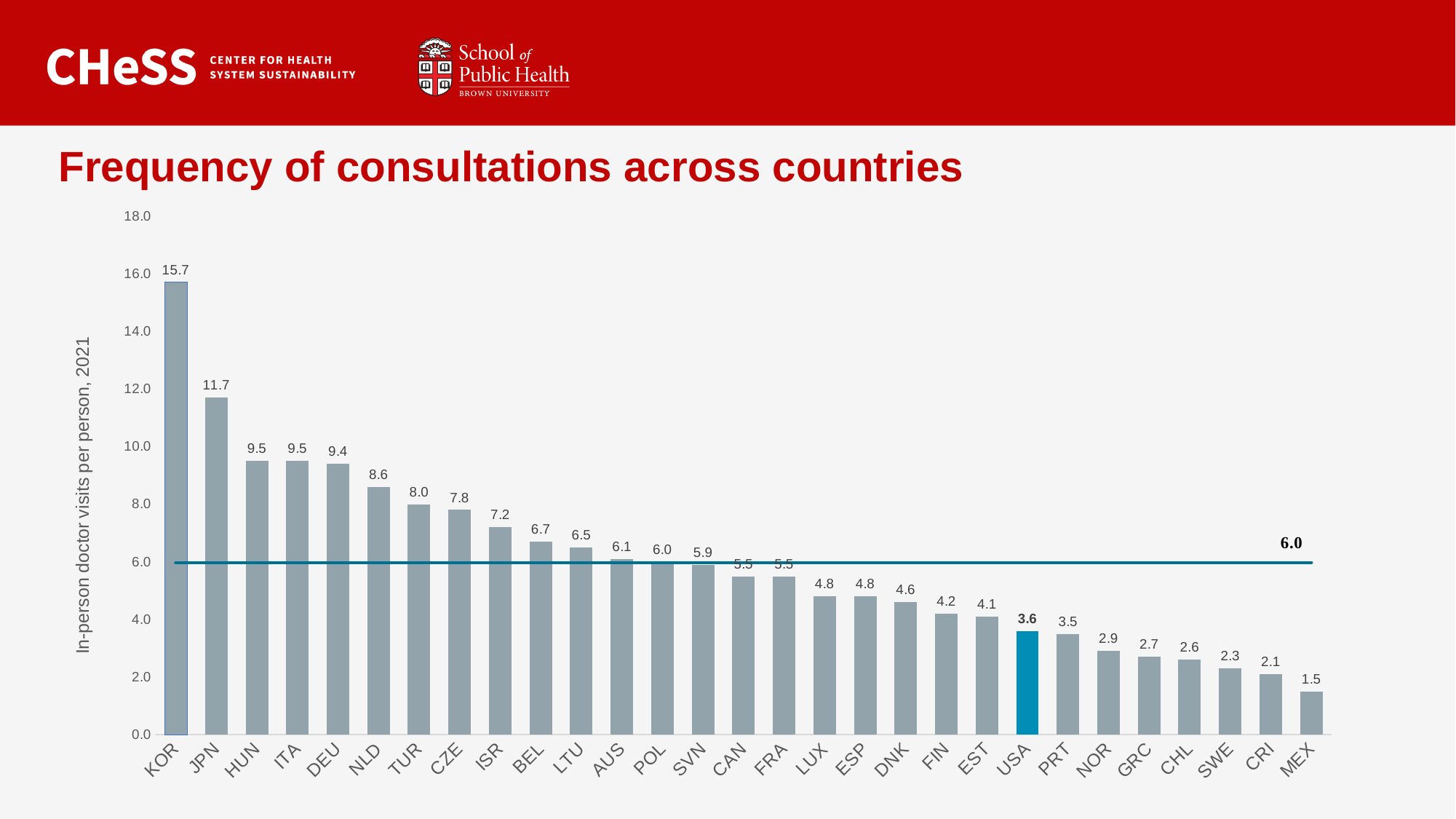
What is the value for KOR? 15.7 What value is marked by the horizontal line across the chart? 6.0 What is the difference between the values for KOR and JPN? 4.0 What is the value for USA? 3.6 What kind of chart is shown on the slide? Bar chart Do the values rise or fall from left to right along the x axis? Fall Which country has the lowest value? MEX Which is larger, the value for NLD or the value for TUR? NLD Which country has the highest value? KOR What is the value for DEU? 9.4 What is the difference between the values for USA and MEX? 2.1 How many countries are shown on the x axis? 29